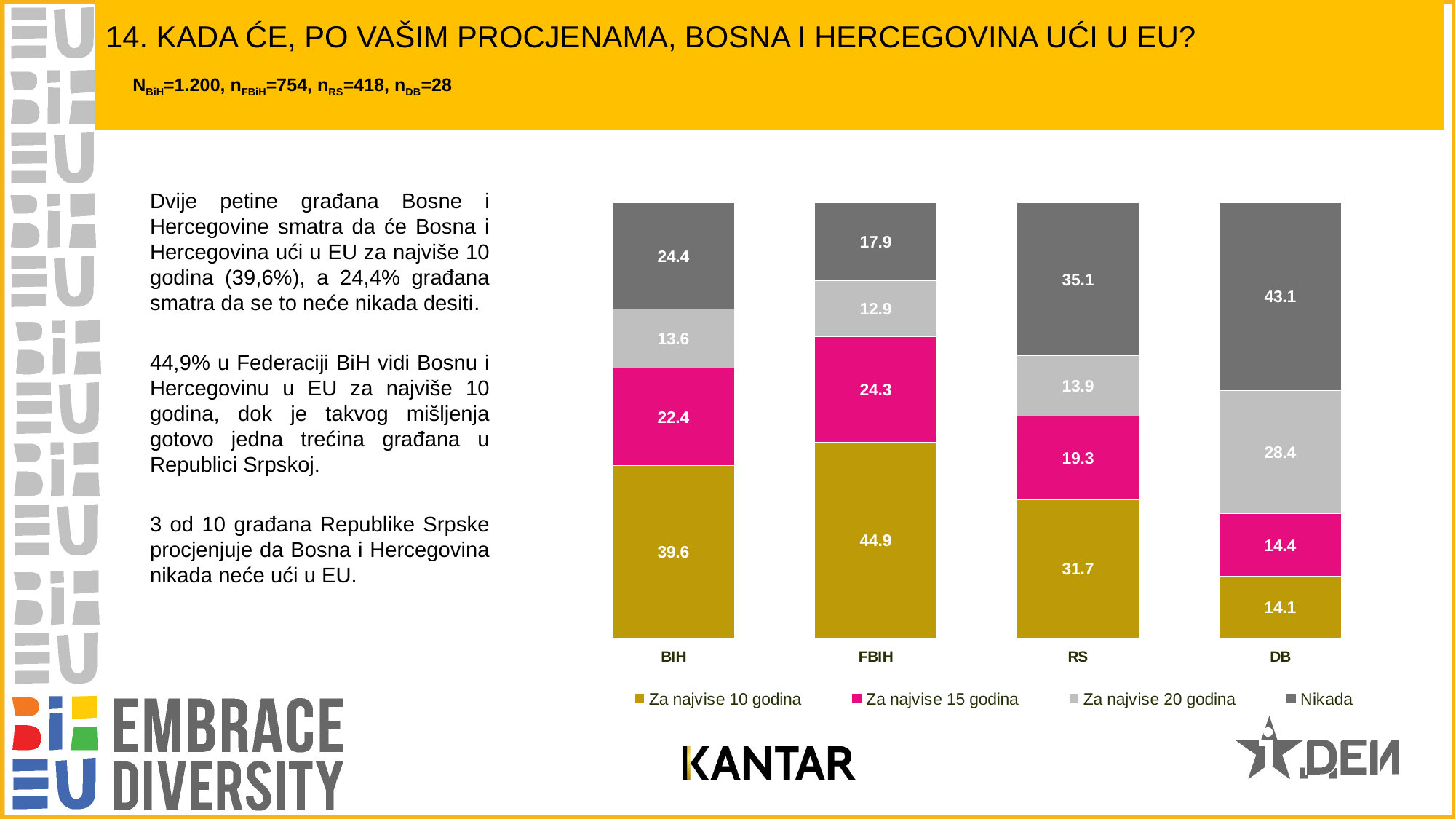
How many series does the legend list? 4 What is the difference between the 'Nikada' values for RS and BIH? 10.7 What type of chart is shown on the slide? Stacked bar chart Which category has the lowest value for 'Za najvise 10 godina'? DB What is the value for 'Nikada' in DB? 43.1 What is the value for 'Za najvise 20 godina' in RS? 13.9 Which category has the highest value for 'Nikada'? DB What is the total of the stacked bar for RS? 100.0 How many categories are shown on the x axis? 4 What is the value for 'Za najvise 10 godina' in FBIH? 44.9 What is the value for 'Za najvise 15 godina' in BIH? 22.4 Which is larger: 'Za najvise 15 godina' in FBIH or in RS? FBIH